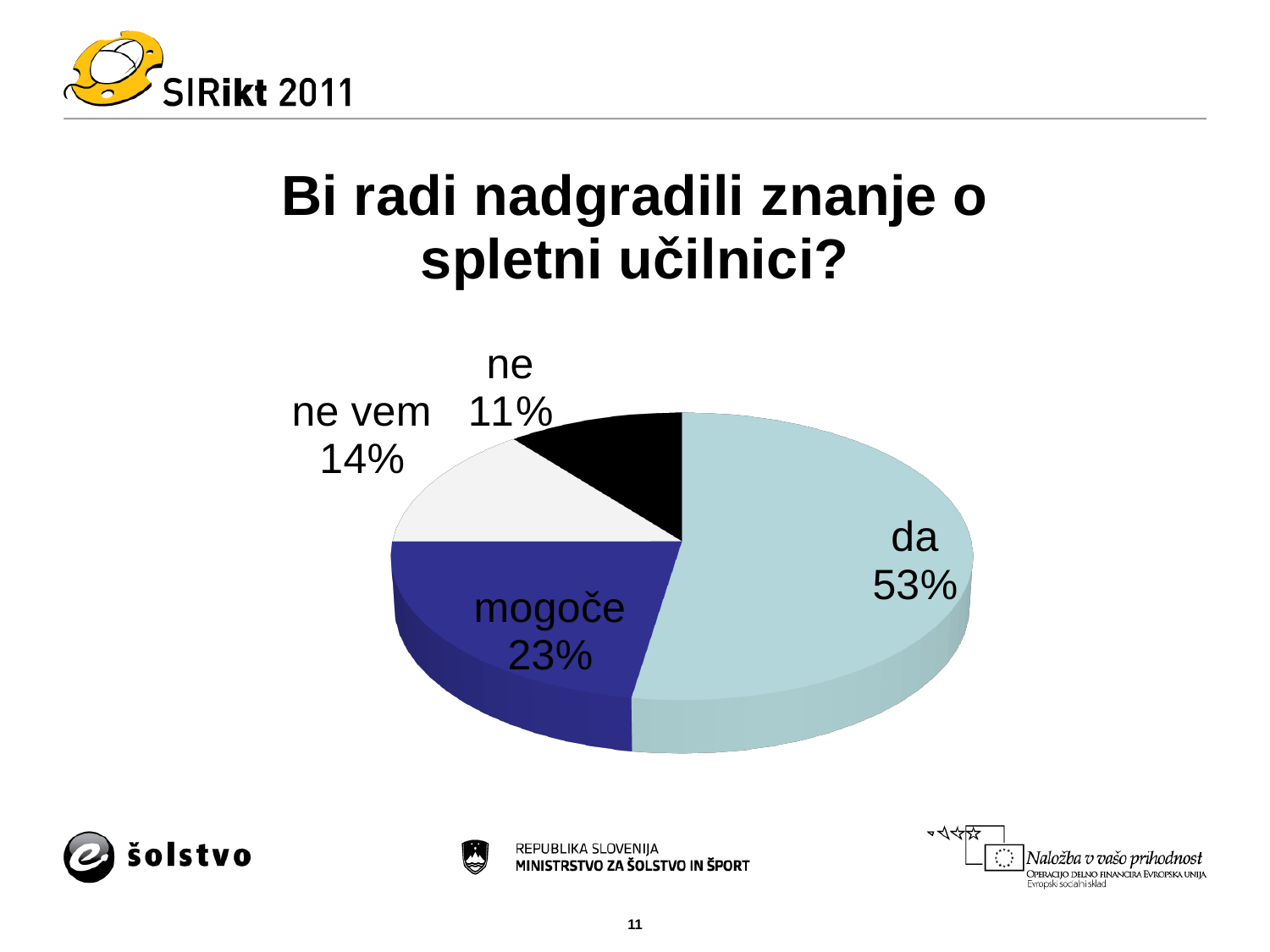
Which category has the largest slice? da Which category has the smallest slice? ne What is the title of the chart? Bi radi nadgradili znanje o spletni učilnici? What is the value for "ne"? 11% How many slices does the pie chart have? 4 What share of the pie does "da" have? 53% Which is larger, "ne vem" or "ne"? ne vem What is the value for "mogoče"? 23% What kind of chart is shown on the slide? pie chart What is the value for "ne vem"? 14% What colour is the "ne" slice? black What is the difference between the values for "da" and "mogoče"? 30%